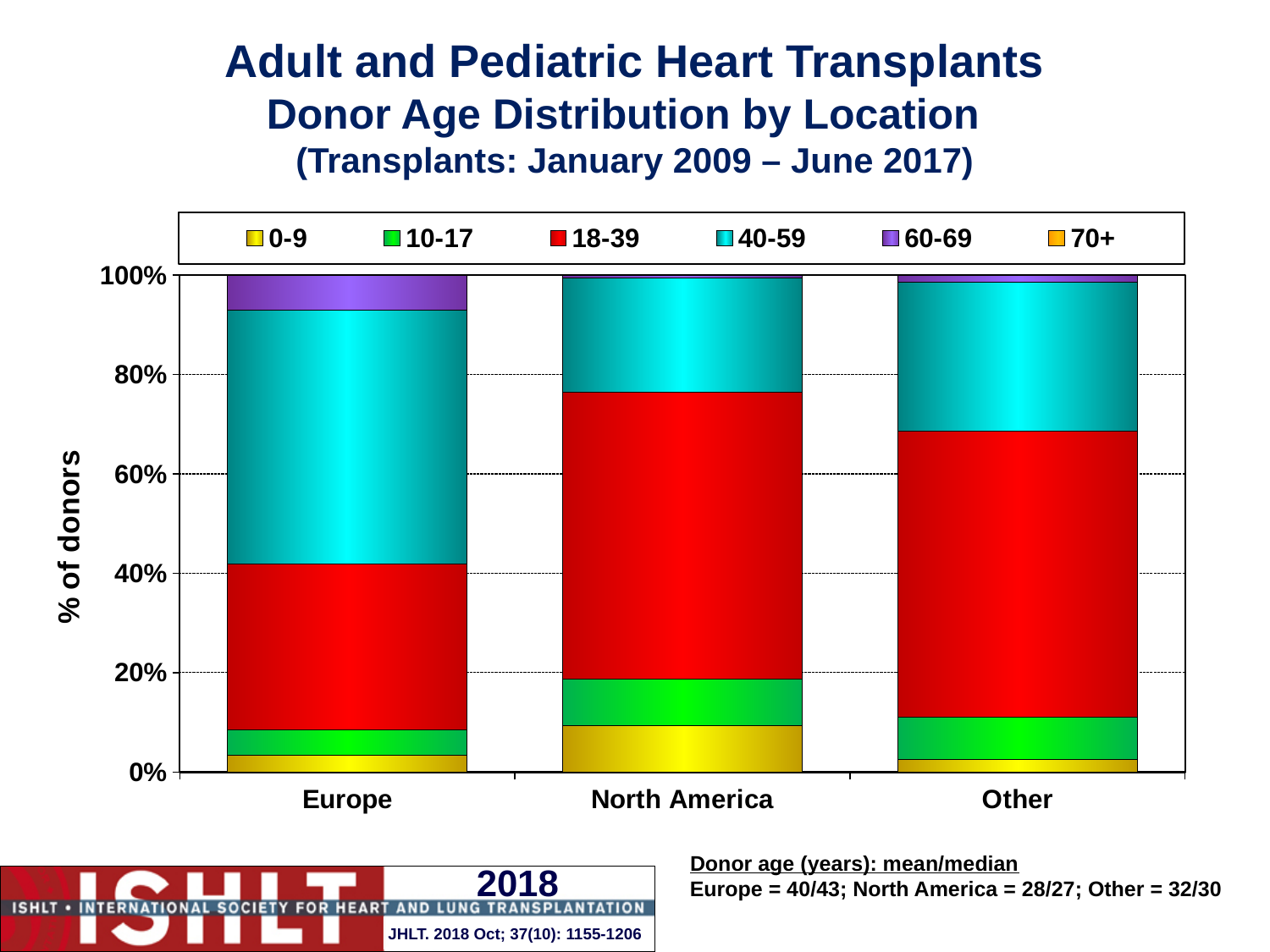
Which location has the largest share of donors aged 0-9? North America Is the share of donors aged 40-59 larger for Europe or for North America? Europe What is the label on the y axis of the chart? % of donors What kind of chart is shown on the slide? Stacked bar chart Which location has the largest share of donors aged 40-59? Europe How many locations are shown on the x axis of the chart? 3 Is the share of donors aged 0-9 in Europe greater or less than 20%? less Which colour represents the 18-39 donor age group in the legend? Red Which location has the smallest share of donors aged 18-39? Europe Is the share of donors aged 18-39 in North America greater or less than 40%? greater Which location has the largest share of donors aged 60-69? Europe How many donor age groups does the legend list? 6